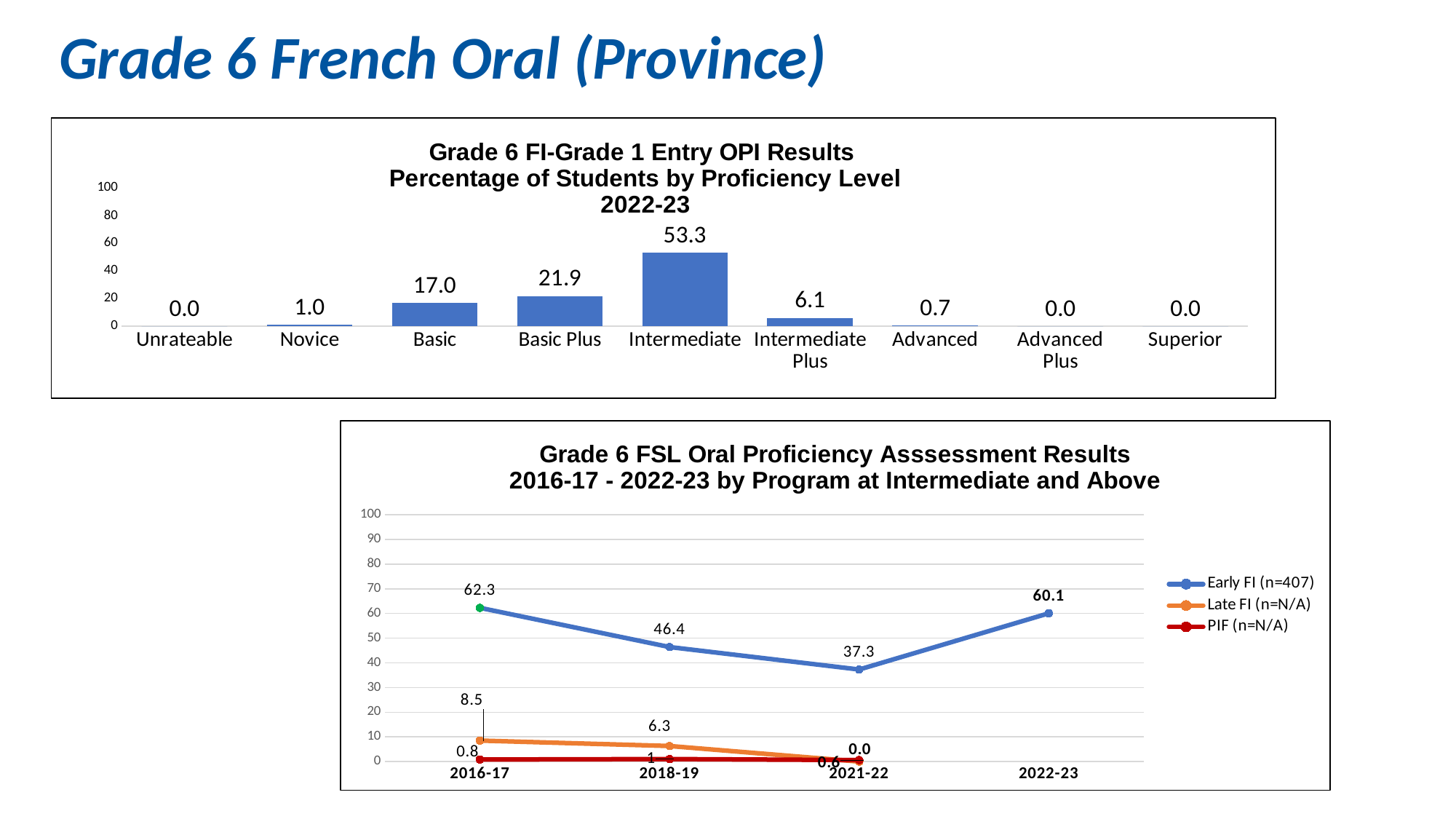
In the top chart (Grade 6 FI-Grade 1 Entry OPI Results), which is larger, the value for Basic or the value for Intermediate Plus? Basic In the top chart (Grade 6 FI-Grade 1 Entry OPI Results), what percentage of students are at the Intermediate level? 53.3 In the top chart (Grade 6 FI-Grade 1 Entry OPI Results), how many proficiency level categories are shown on the x axis? 9 In the top chart (Grade 6 FI-Grade 1 Entry OPI Results), which proficiency level has the highest percentage of students? Intermediate In the bottom chart (Grade 6 FSL Oral Proficiency Assessment Results), in which year was the Early FI value lowest? 2021-22 In the bottom chart (Grade 6 FSL Oral Proficiency Assessment Results), what is the difference between the Early FI values for 2016-17 and 2018-19? 15.9 In the bottom chart (Grade 6 FSL Oral Proficiency Assessment Results), what is the Early FI value for 2022-23? 60.1 In the bottom chart (Grade 6 FSL Oral Proficiency Assessment Results), how many series does the legend list? 3 What kind of chart is the top chart (Grade 6 FI-Grade 1 Entry OPI Results)? Bar chart In the top chart (Grade 6 FI-Grade 1 Entry OPI Results), what is the difference between the Intermediate and Basic Plus values? 31.4 In the top chart (Grade 6 FI-Grade 1 Entry OPI Results), what is the value for Basic Plus? 21.9 In the bottom chart (Grade 6 FSL Oral Proficiency Assessment Results), what is the Early FI value for 2021-22? 37.3